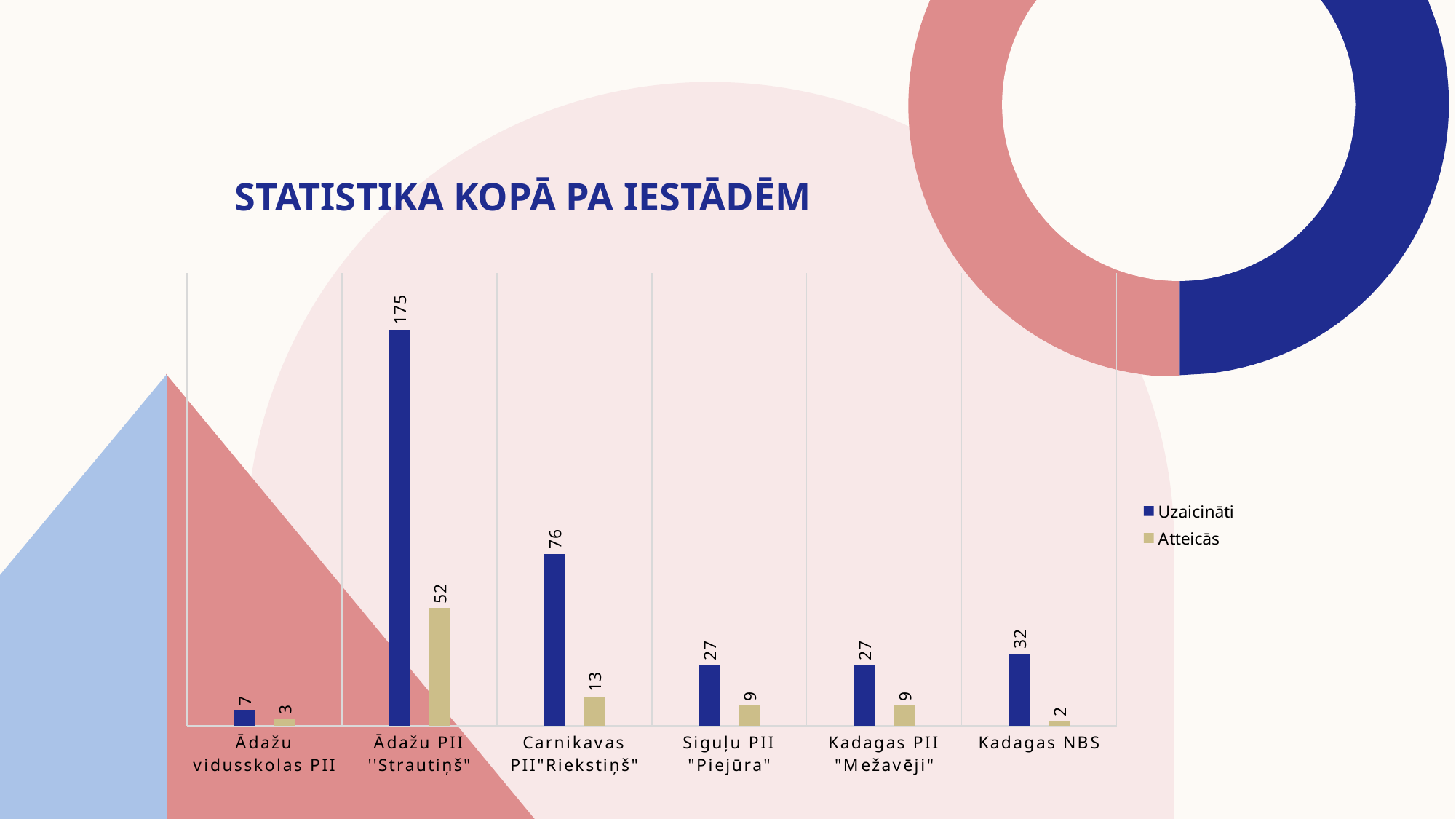
Which category has the highest Uzaicināti value? Ādažu PII ''Strautiņš'' Which category has the lowest Atteicās value? Kadagas NBS What is the Uzaicināti value for Ādažu PII ''Strautiņš''? 175 What kind of chart is shown on the slide? Bar chart Which is larger: the Uzaicināti value for Carnikavas PII"Riekstiņš" or the Uzaicināti value for Kadagas NBS? Carnikavas PII"Riekstiņš" What is the difference between the Uzaicināti and Atteicās values for Ādažu PII ''Strautiņš''? 123 What is the Atteicās value for Carnikavas PII"Riekstiņš"? 13 What is the title of the chart? STATISTIKA KOPĀ PA IESTĀDĒM What is the Atteicās value for Ādažu vidusskolas PII? 3 What is the Uzaicināti value for Kadagas NBS? 32 How many series does the legend list? 2 How many categories are shown on the x axis? 6